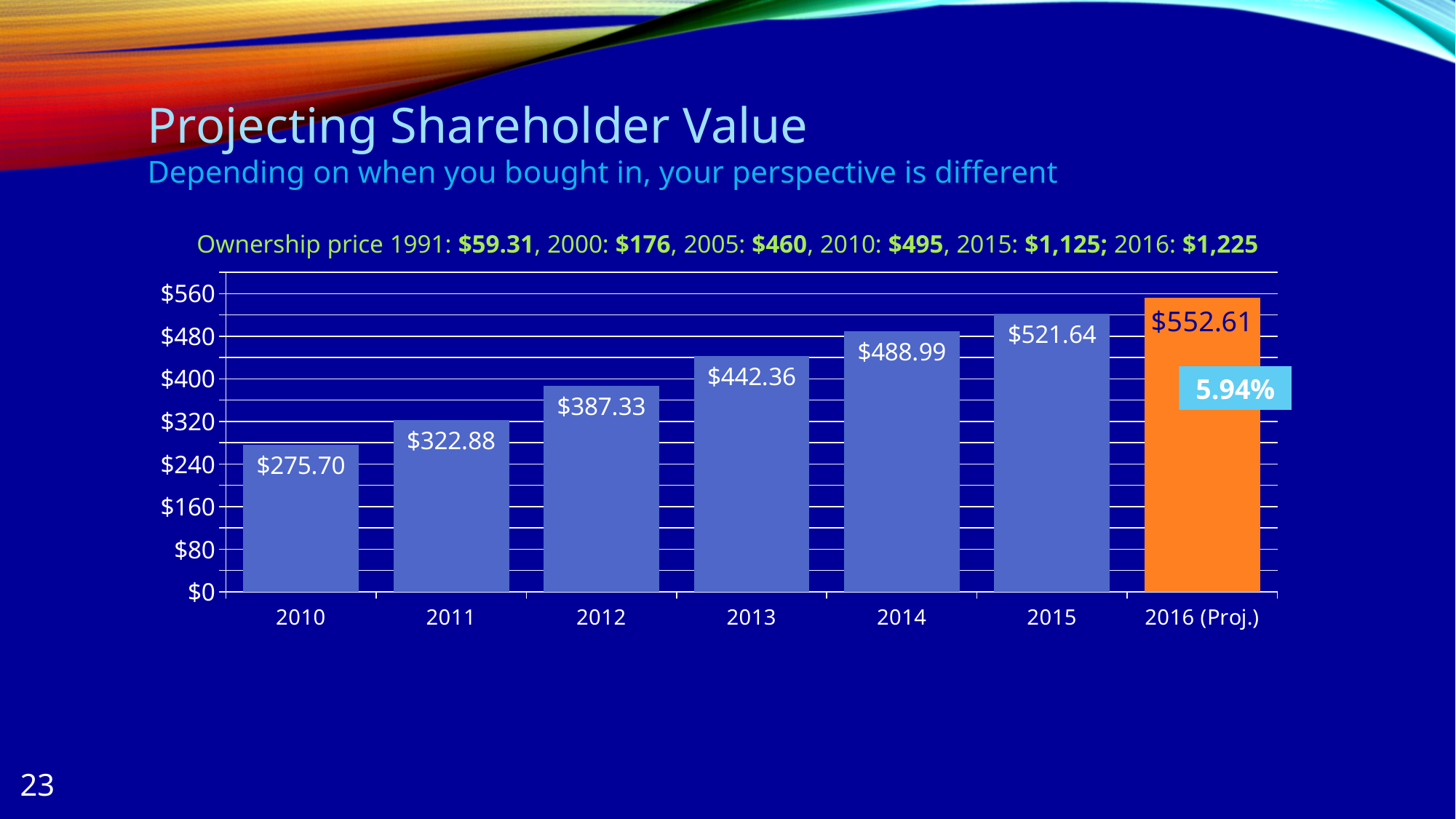
Is the value for 2014 greater or less than $480? greater What is the value shown for 2013? $442.36 Do the values rise or fall from 2010 to 2016 (Proj.)? rise What is the difference between the 2016 (Proj.) value and the 2010 value? $276.91 What is the difference between the 2015 value and the 2014 value? $32.65 What is the projected value shown for 2016 (Proj.)? $552.61 What is the value shown for 2010? $275.70 Which is larger, the value for 2012 or the value for 2011? 2012 How many years (bars) are shown in the chart? 7 Which year has the lowest value in the chart? 2010 Which year has the highest value in the chart? 2016 (Proj.) What kind of chart is shown on the slide? bar chart